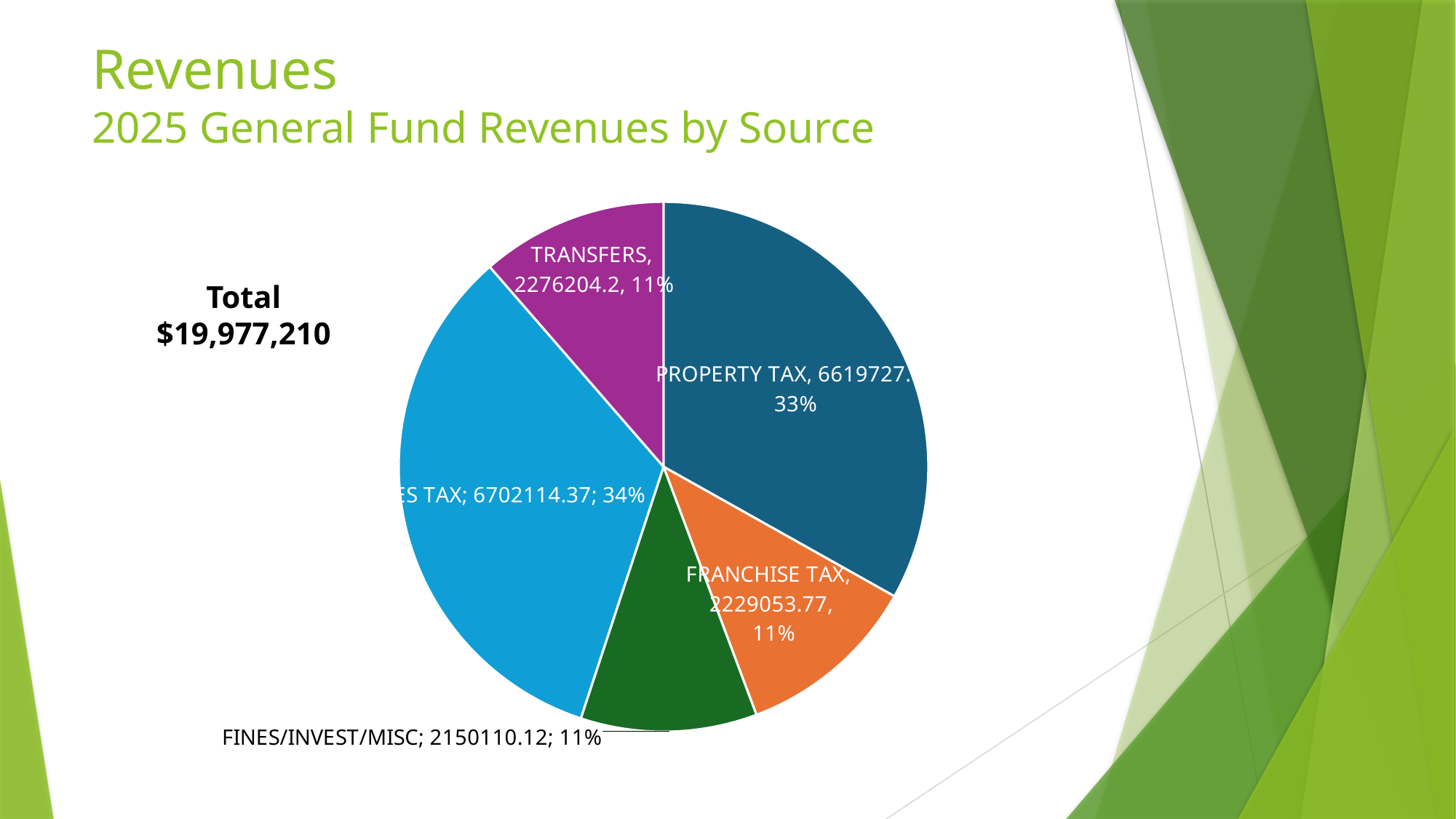
What share of the pie does TRANSFERS represent? 11% Which has the larger value, FRANCHISE TAX or FINES/INVEST/MISC? FRANCHISE TAX What share of the pie does PROPERTY TAX represent? 33% What value is shown for FRANCHISE TAX? 2229053.77 What value is shown for TRANSFERS? 2276204.2 Which source has the smallest printed value on the chart? FINES/INVEST/MISC What value is shown for FINES/INVEST/MISC? 2150110.12 What total is printed next to the pie chart? $19,977,210 How many slices does the pie chart have? 5 What is the difference between the TRANSFERS value and the FRANCHISE TAX value? 47150.43 What kind of chart is shown on the slide? pie chart What share of the pie does the largest slice represent? 34%